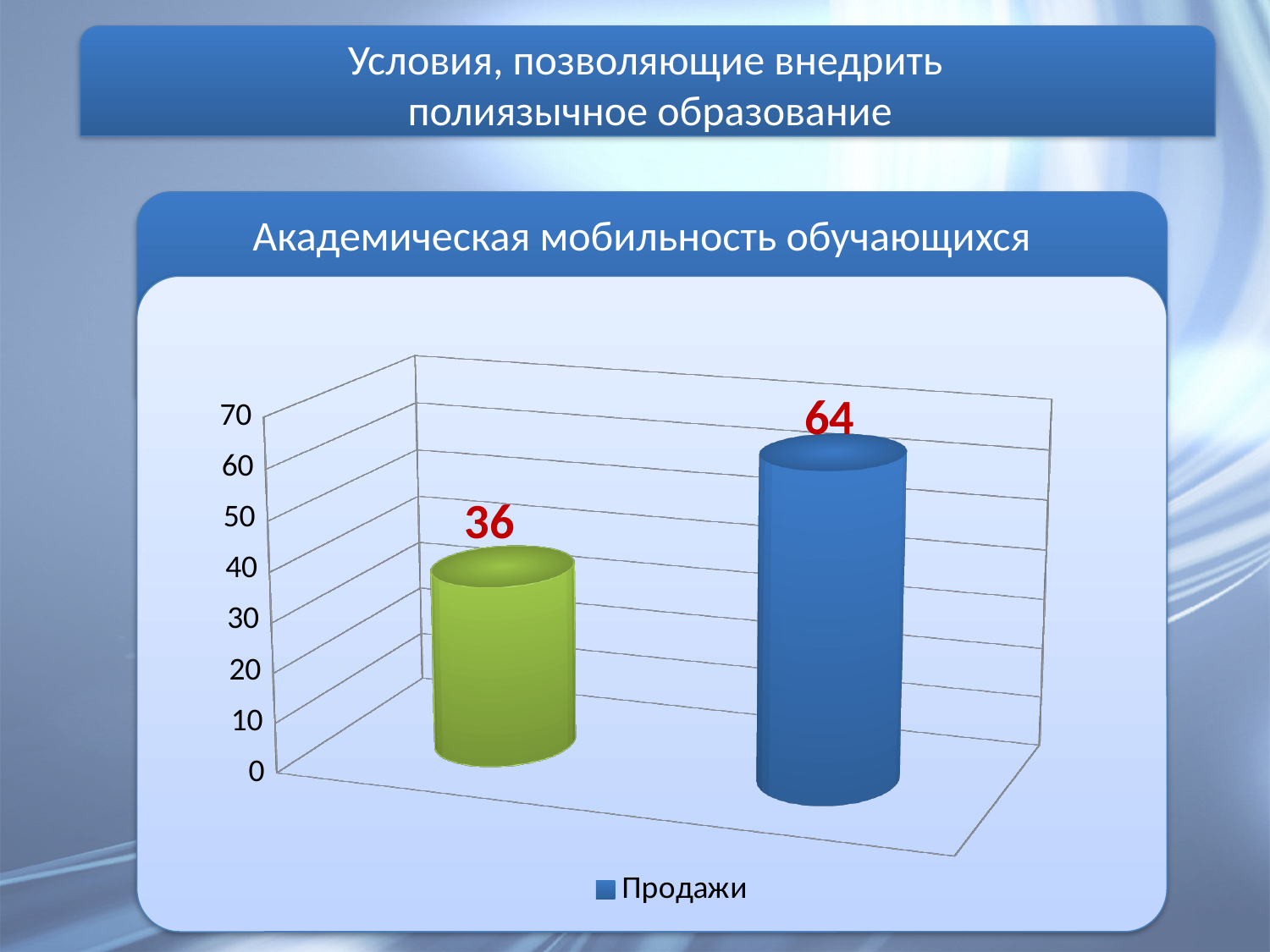
How many series does the legend list? 1 How many bars are plotted in the chart? 2 What is the difference between the blue bar's value and the green bar's value? 28 Which bar has the highest value, the green one or the blue one? the blue bar What is the series name shown in the chart legend? Продажи Which bar has the lowest value, the green one or the blue one? the green bar Is the value for the blue bar greater or less than 60? greater What value is shown on the green bar? 36 Is the value for the green bar greater or less than 50? less What kind of chart is shown on the slide? bar chart Is the value of the blue bar larger or smaller than the value of the green bar? larger What value is shown on the blue bar? 64